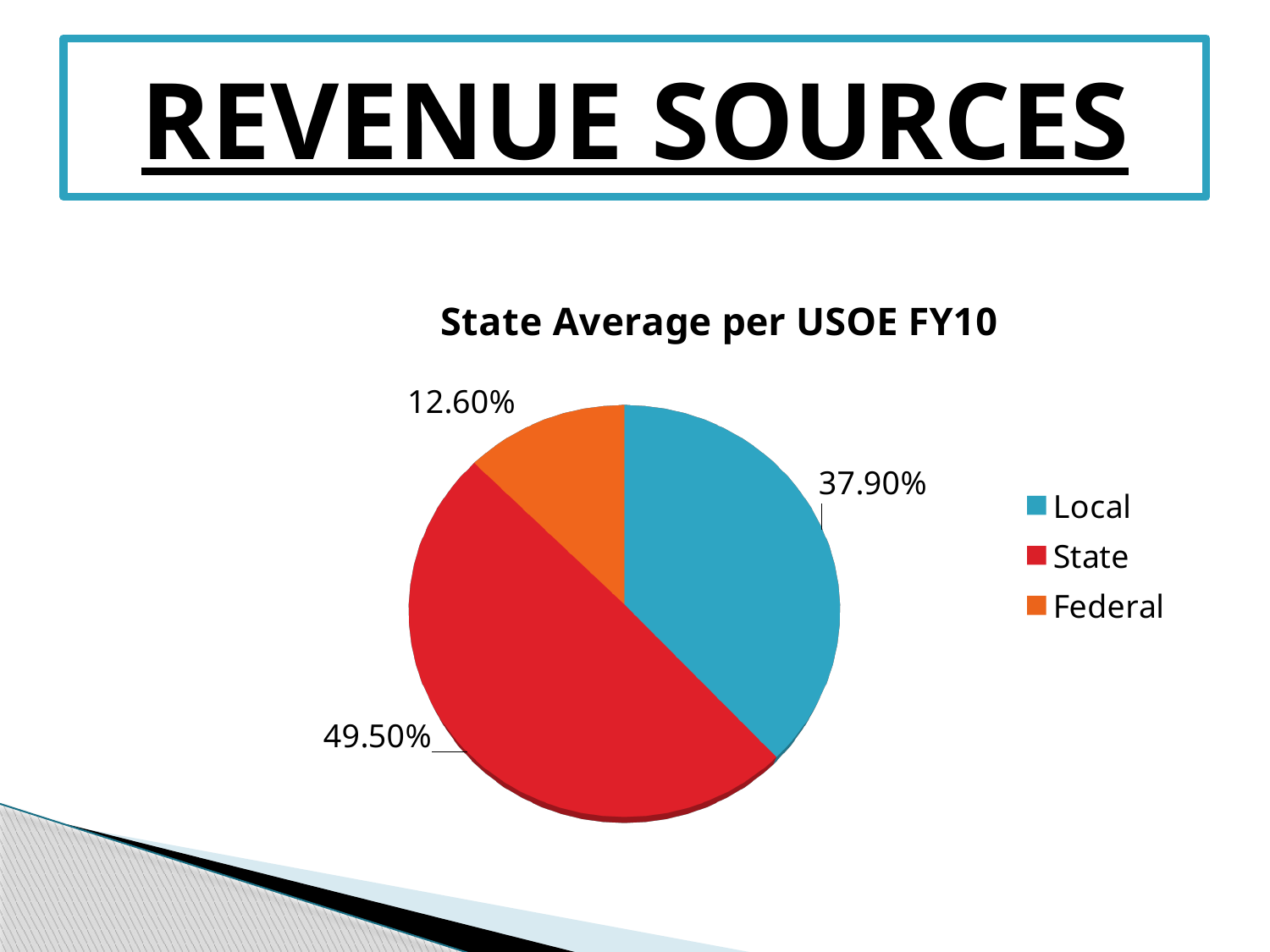
What share of revenue comes from State sources? 49.50% Which revenue source has the smallest share? Federal What share of revenue comes from Federal sources? 12.60% How many slices does the pie chart have? 3 What is the difference between the Local share and the Federal share? 25.30% What share of revenue comes from Local sources? 37.90% What is the title of the chart? State Average per USOE FY10 What is the difference between the State share and the Local share? 11.60% What type of chart is shown on the slide? pie chart Which is larger, the Local share or the Federal share? Local Which revenue source has the largest share? State Which colour represents the State slice in the legend? red